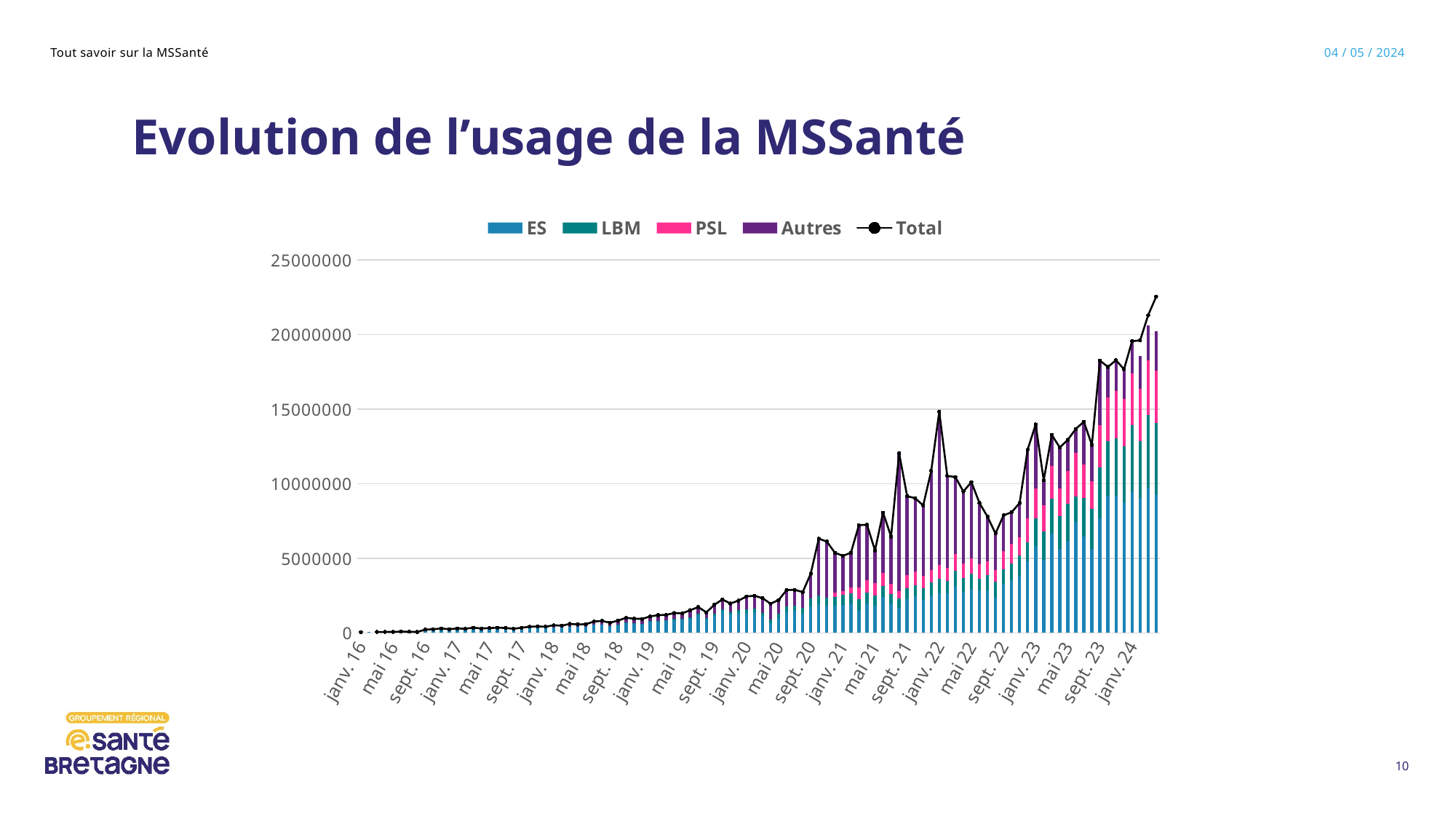
What is the title of the slide's chart? Evolution de l'usage de la MSSanté Is the Total value for sept. 23 greater or less than 15000000? greater Which legend entry is drawn as a line with markers rather than as bars? Total What kind of chart is shown on the slide? Stacked bar chart with a line for Total Which has the larger Total value, janv. 22 or sept. 22? janv. 22 Which has the larger Total value, janv. 24 or janv. 16? janv. 24 Is the highest Total value on the chart greater or less than 20000000? greater How many series does the legend list? 5 Overall, does the Total line rise or fall from janv. 16 to janv. 24? Rise Is the Total value for janv. 23 greater or less than 10000000? greater